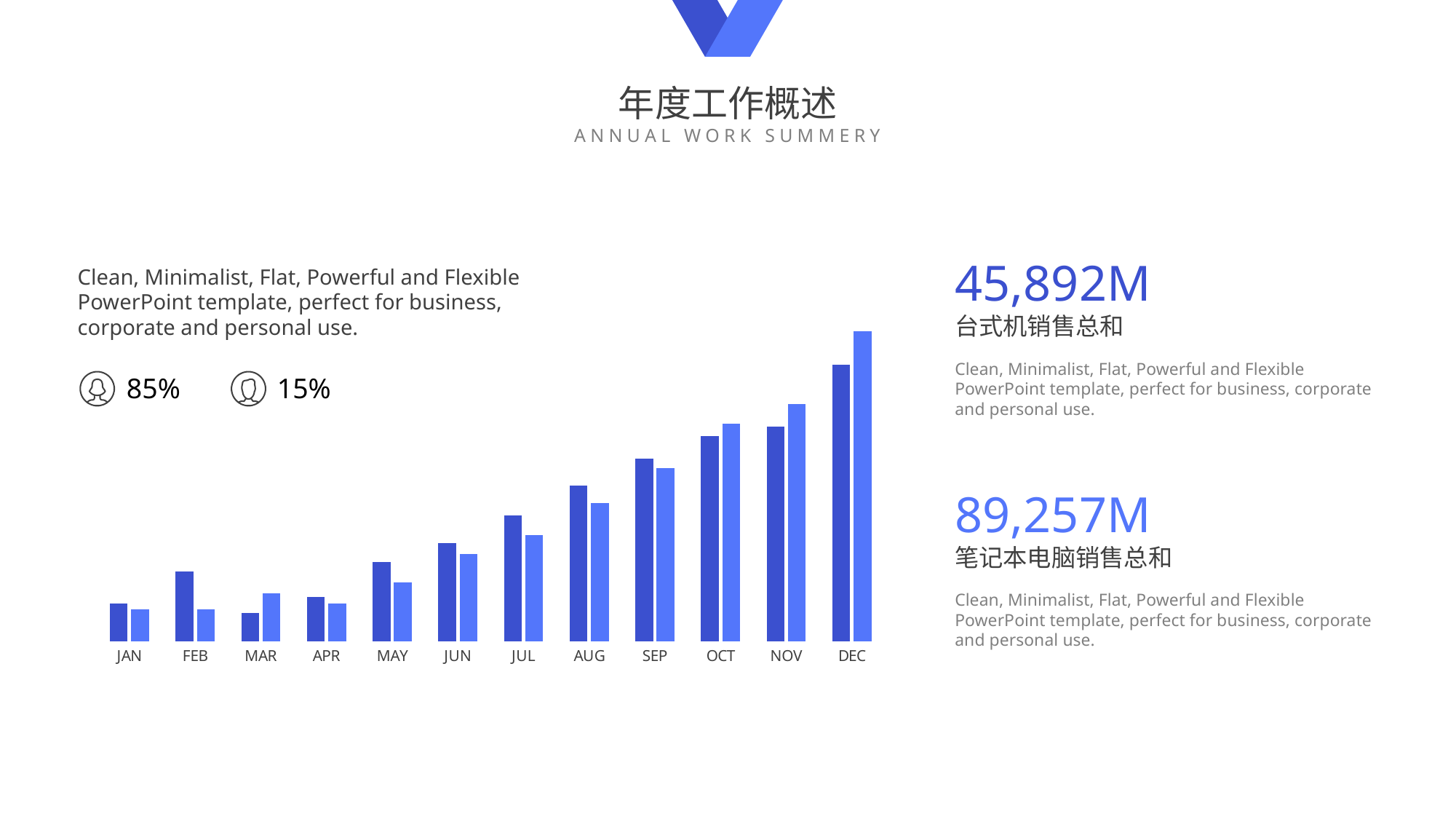
In FEB, which bar is taller, the dark blue or the light blue one? dark blue What kind of chart is shown on the slide? bar chart In MAR, which bar is taller, the dark blue or the light blue one? light blue Which month has the shortest dark blue bar? MAR Which month has the shortest light blue bar? JAN and FEB (tied) How many months are shown on the x axis of the chart? 12 In DEC, which bar is taller, the dark blue or the light blue one? light blue Which month has the tallest light blue bar? DEC Which month has the tallest dark blue bar? DEC Do the bars generally rise or fall from JAN to DEC? rise How many bars are plotted for each month in the chart? 2 What is the first month label on the x axis of the chart? JAN